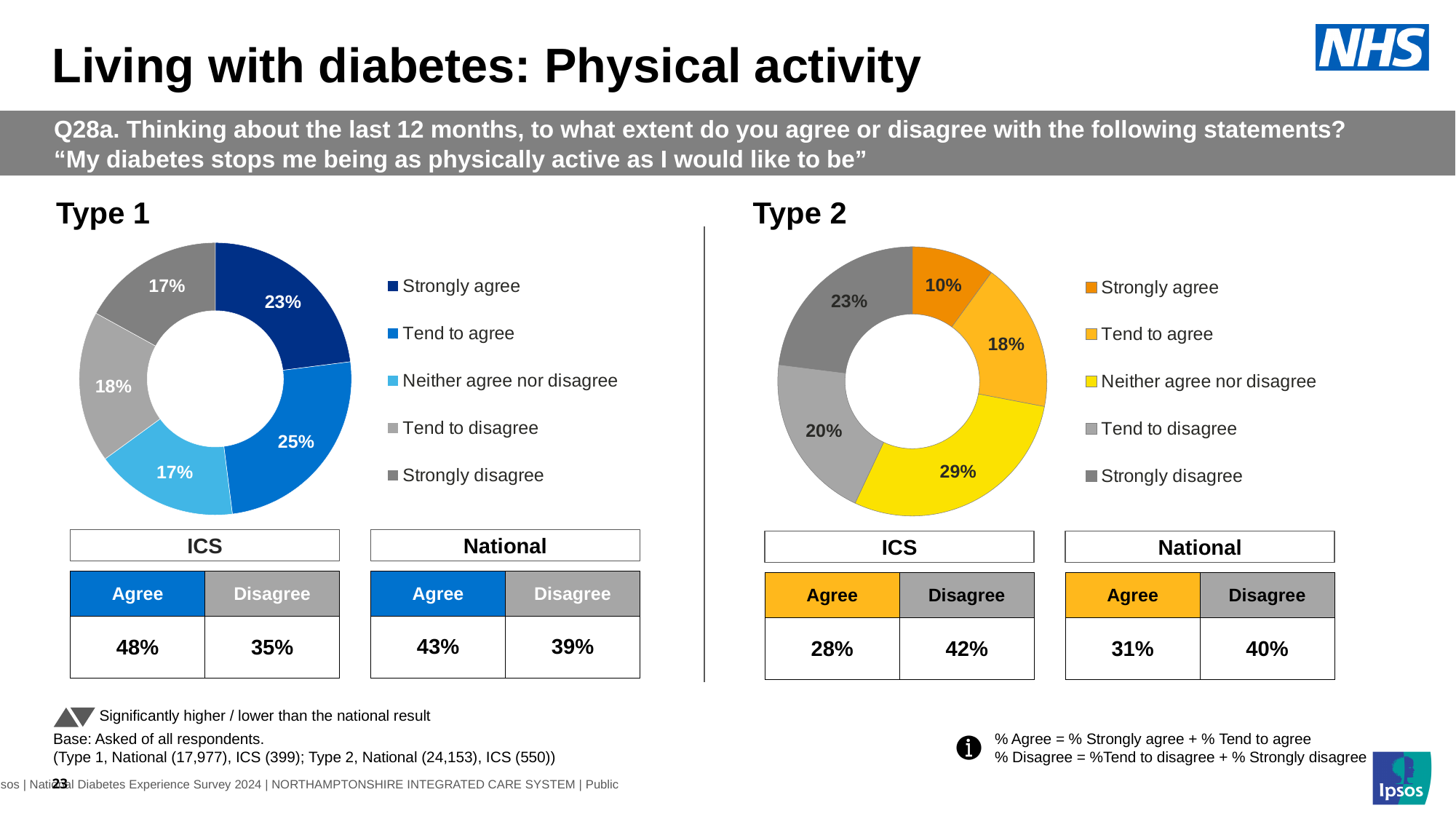
Which is larger: 'Strongly agree' in the Type 1 chart or 'Strongly agree' in the Type 2 chart? Type 1 In the Type 2 chart, what percentage of respondents said 'Neither agree nor disagree'? 29% In the Type 2 chart, what percentage of respondents said 'Tend to disagree'? 20% How many response categories does the Type 2 chart's legend list? 5 In the Type 1 chart, what percentage of respondents said 'Strongly agree'? 23% In the Type 2 chart, what is the difference between the 'Strongly disagree' and 'Strongly agree' percentages? 13% In the Type 2 chart, which response category has the largest share? Neither agree nor disagree In the Type 2 chart, which response category has the smallest share? Strongly agree In the Type 1 chart, what is the difference between the 'Tend to agree' and 'Strongly disagree' percentages? 8% In the Type 2 chart, what colour is the 'Neither agree nor disagree' segment? Yellow What kind of chart is used for the Type 1 results? Doughnut (pie) chart In the Type 1 chart, which response category has the largest share? Tend to agree